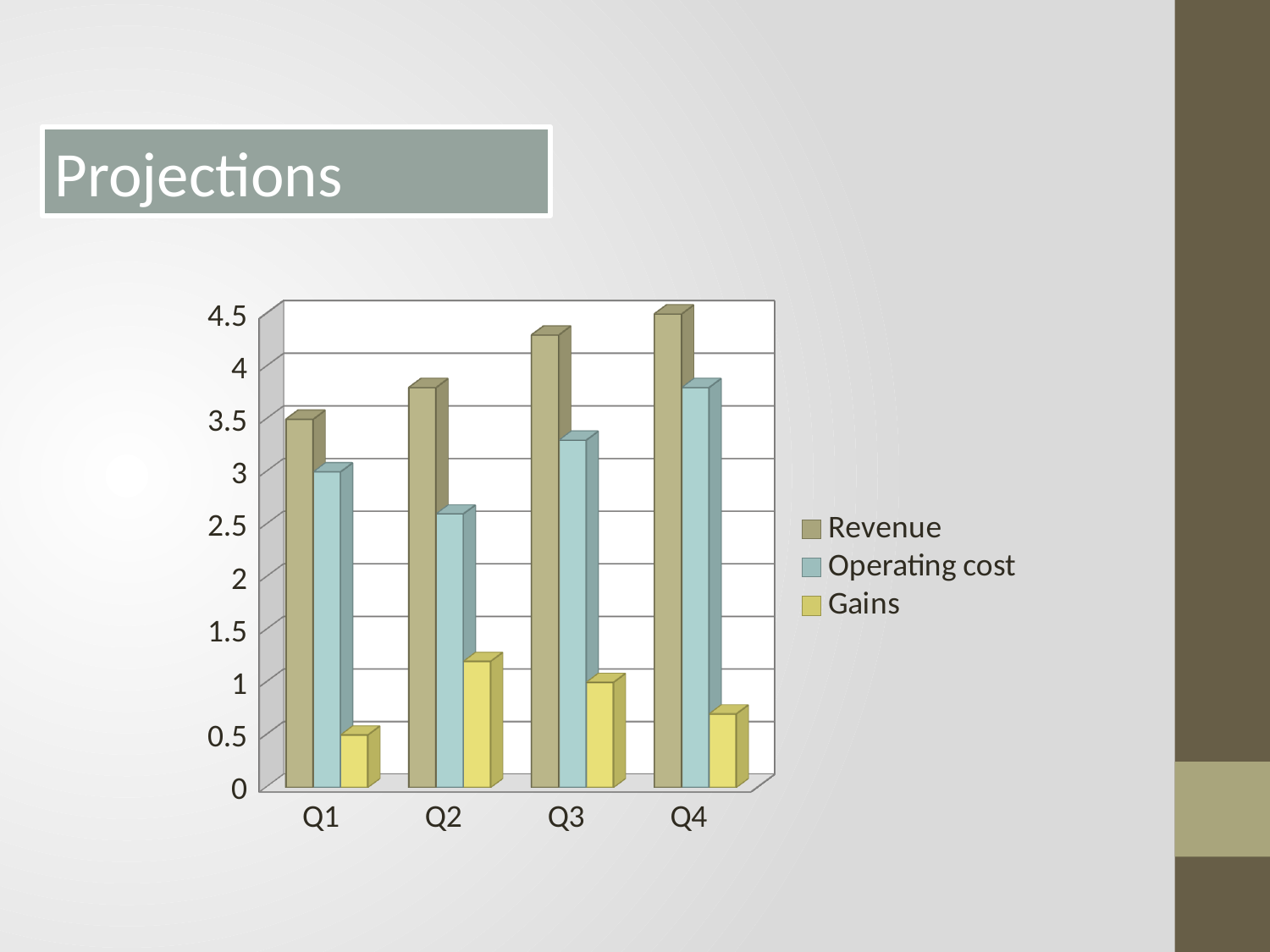
In which quarter is Revenue highest? Q4 Is the Revenue value for Q1 greater or less than 4? less How many quarters are shown on the x axis? 4 In which quarter is Operating cost lowest? Q2 How many series does the legend list? 3 What kind of chart is shown on the slide? bar chart Is the Revenue value for Q4 greater or less than 4? greater In which quarter is Gains lowest? Q1 Is the Operating cost value for Q2 greater or less than 3? less Does Revenue rise or fall from Q1 to Q4? rise In Q1, which is larger, Revenue or Operating cost? Revenue